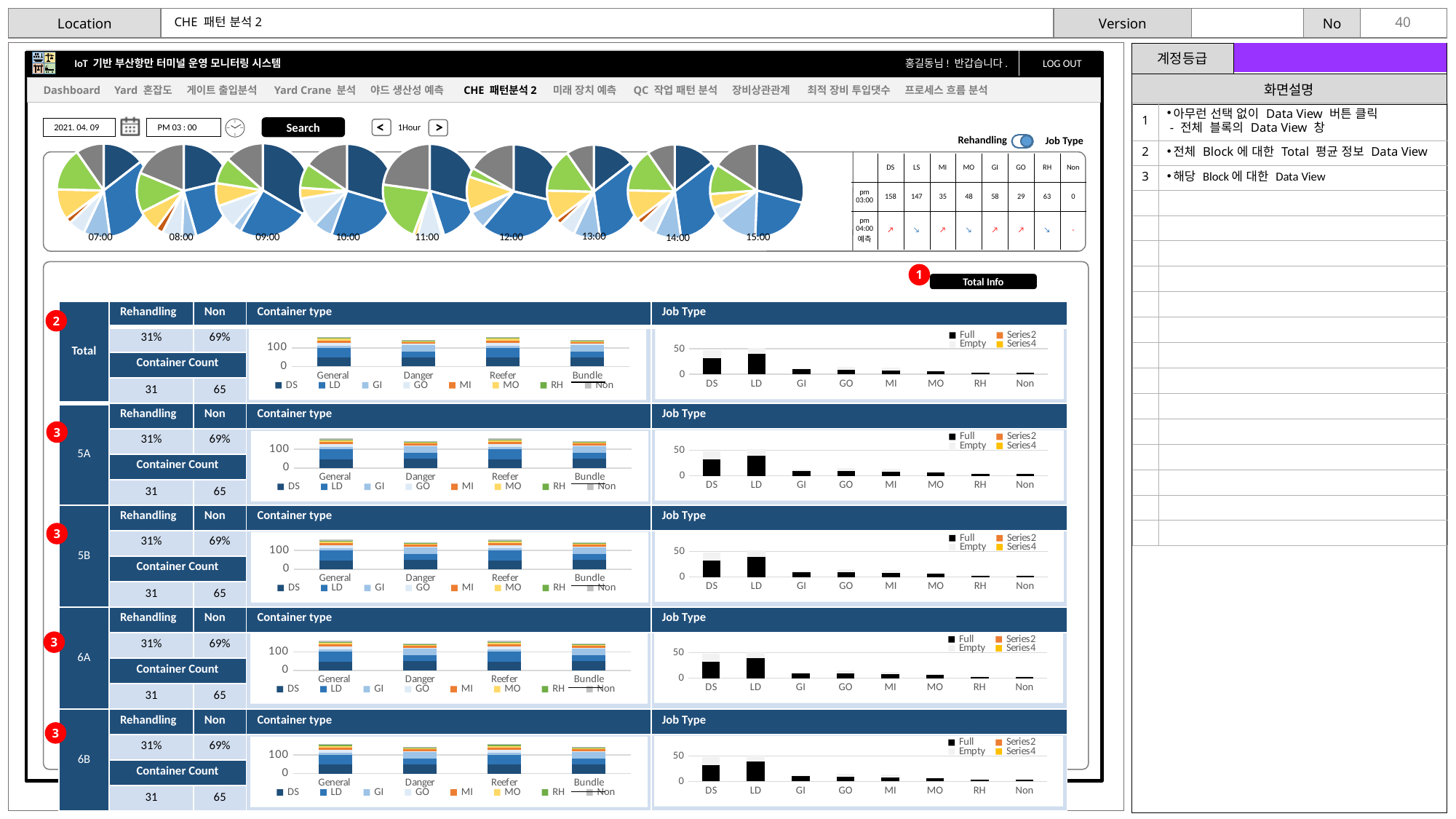
What kind of charts are shown in the row of time-labelled charts at the top of the screen (07:00 to 15:00)? pie charts What kind of chart is the 'Container type' chart in the 5B row? bar chart In the 'Job Type' chart of the Total row, is the value for DS greater or less than 50? less How many pie charts are shown in the top row of the screen? 9 What is the first legend entry of the 'Job Type' chart in the 6B row? Full In the 'Job Type' chart of the 5A row, which is larger, the bar for LD or the bar for GI? LD How many series does the legend of the 'Container type' chart in the Total row list? 8 What kind of chart is the 'Job Type' chart in the Total row? bar chart In the 'Job Type' chart of the Total row, which category has the highest bar? LD How many categories are shown on the x axis of the 'Job Type' chart in the Total row? 8 How many categories are shown on the x axis of the 'Container type' chart in the Total row? 4 How many series does the legend of the 'Job Type' chart in the Total row list? 4